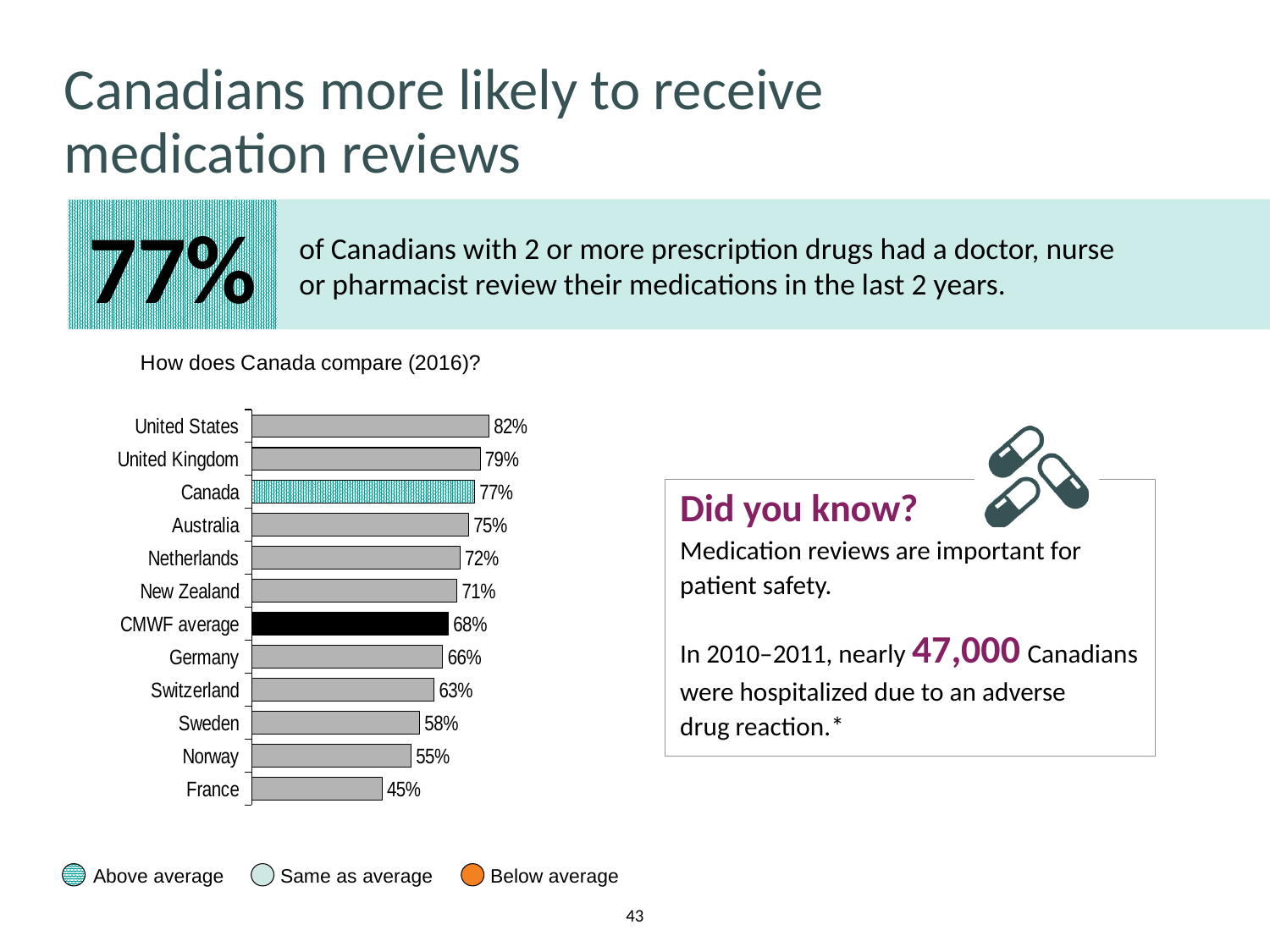
Which is larger, the value for Germany or the value for Sweden? Germany What is the value for the CMWF average? 68% What is the value for Canada in the chart? 77% What is the difference between the values for United States and France? 37% What is the value for Netherlands? 72% What is the difference between the values for Canada and the CMWF average? 9% What is the title of the chart? How does Canada compare (2016)? What kind of chart is shown on the slide? Bar chart Which category has the lowest value in the chart? France Which category has the highest value in the chart? United States Which bar in the chart is drawn in black? CMWF average How many categories (bars) are shown in the chart? 12